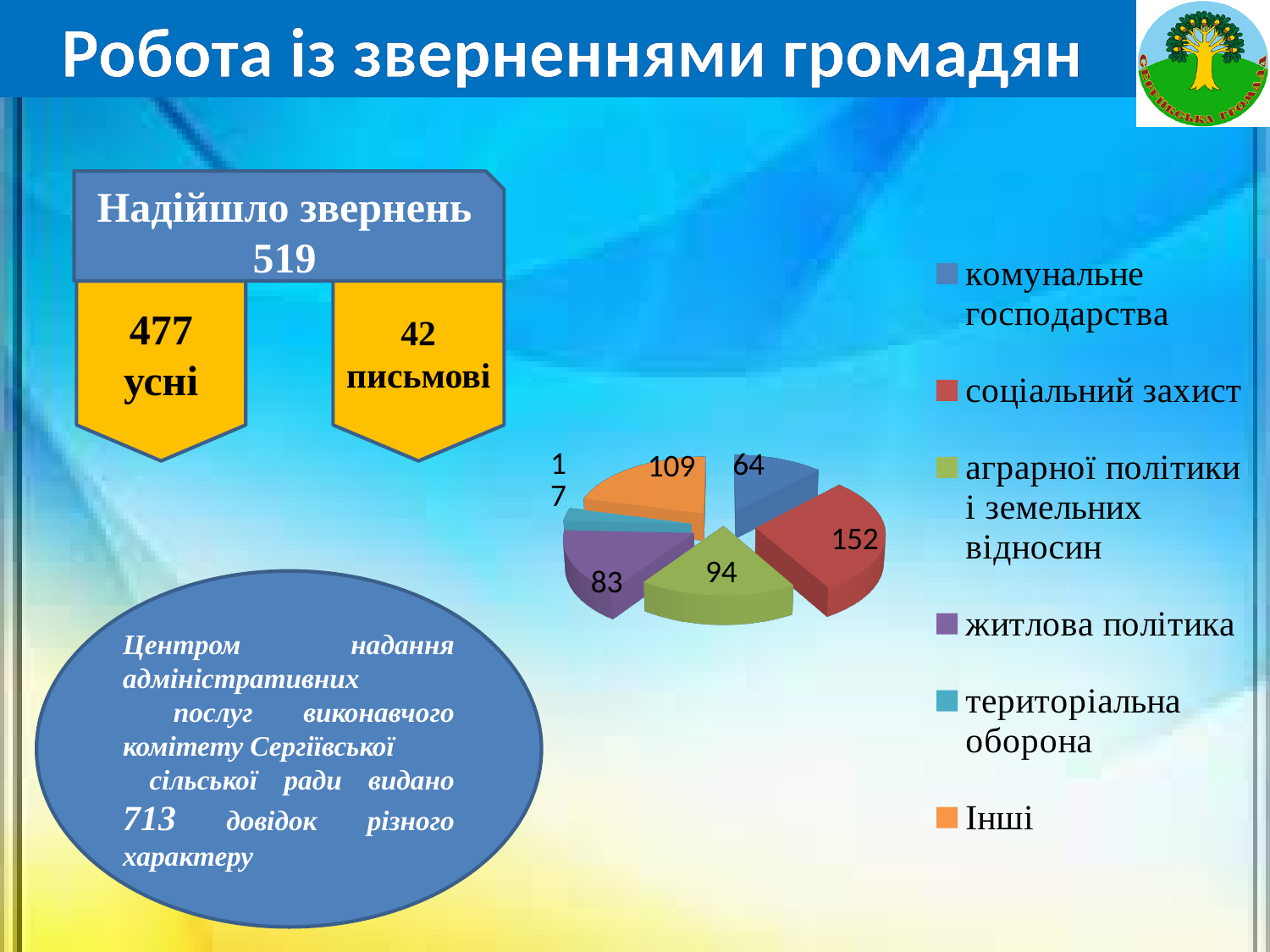
How many entries does the legend of the pie chart list? 6 What is the value for комунальне господарства in the pie chart? 64 What is the value for Інші in the pie chart? 109 Which category has the smallest slice in the pie chart? територіальна оборона How many slices does the pie chart have? 6 Which is larger in the pie chart, Інші or житлова політика? Інші What kind of chart is shown on the slide? pie chart What is the value for соціальний захист in the pie chart? 152 What is the value for аграрної політики і земельних відносин in the pie chart? 94 Which category has the largest slice in the pie chart? соціальний захист What is the value for житлова політика in the pie chart? 83 What is the difference between the values for соціальний захист and аграрної політики і земельних відносин? 58